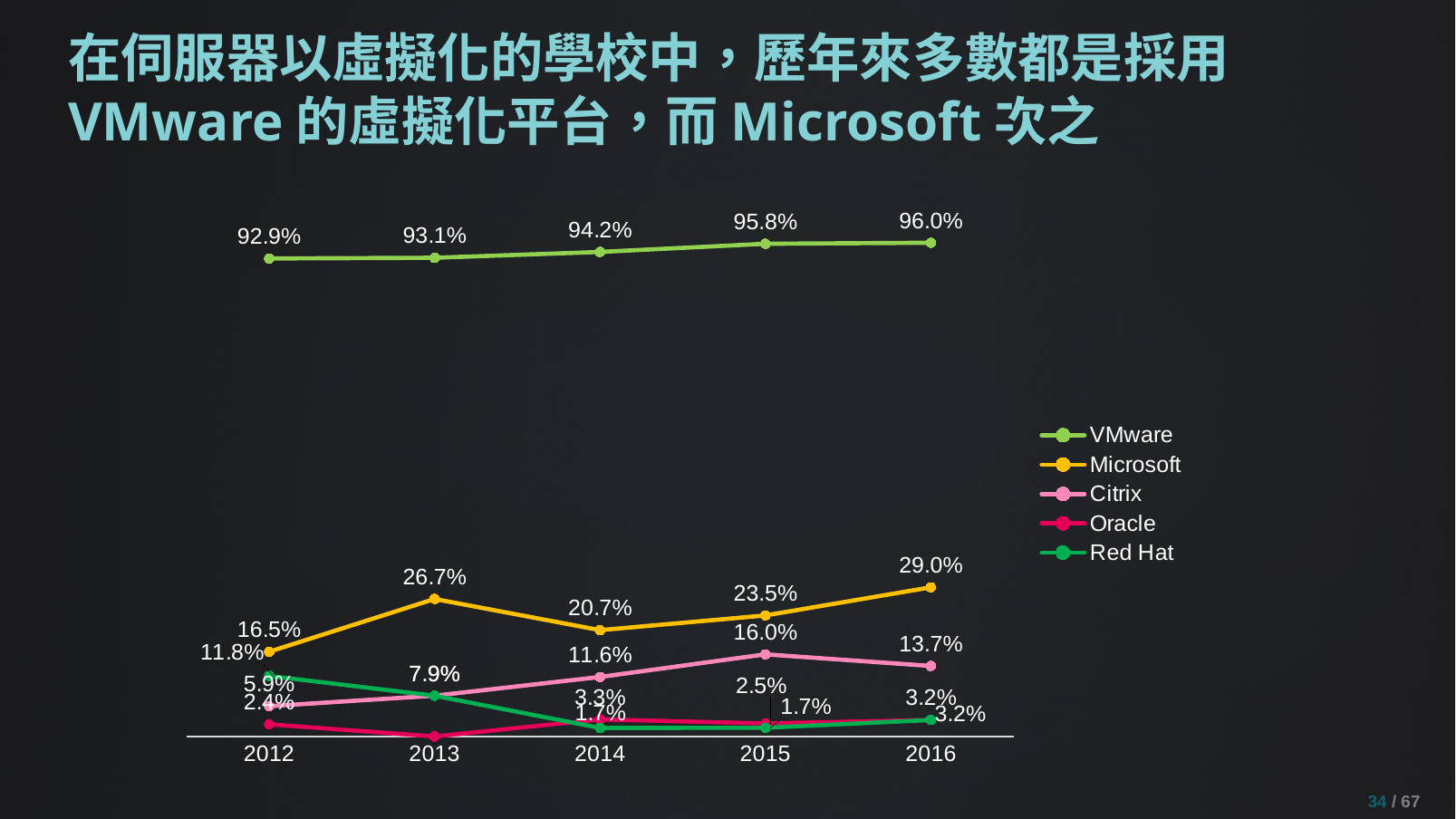
What is the difference between the VMware values in 2016 and 2012? 3.1% Which series has the highest value in 2016? VMware How many years are shown on the x axis? 5 What is the value for Citrix in 2015? 16.0% What type of chart is shown on the slide? line chart Which is larger in 2014, the Microsoft value or the Citrix value? Microsoft How many series does the legend list? 5 What is the value for Microsoft in 2013? 26.7% What is the value for VMware in 2016? 96.0% In which year is the Microsoft value lowest? 2012 What is the value for VMware in 2012? 92.9% Does the VMware line rise or fall from 2012 to 2016? rise